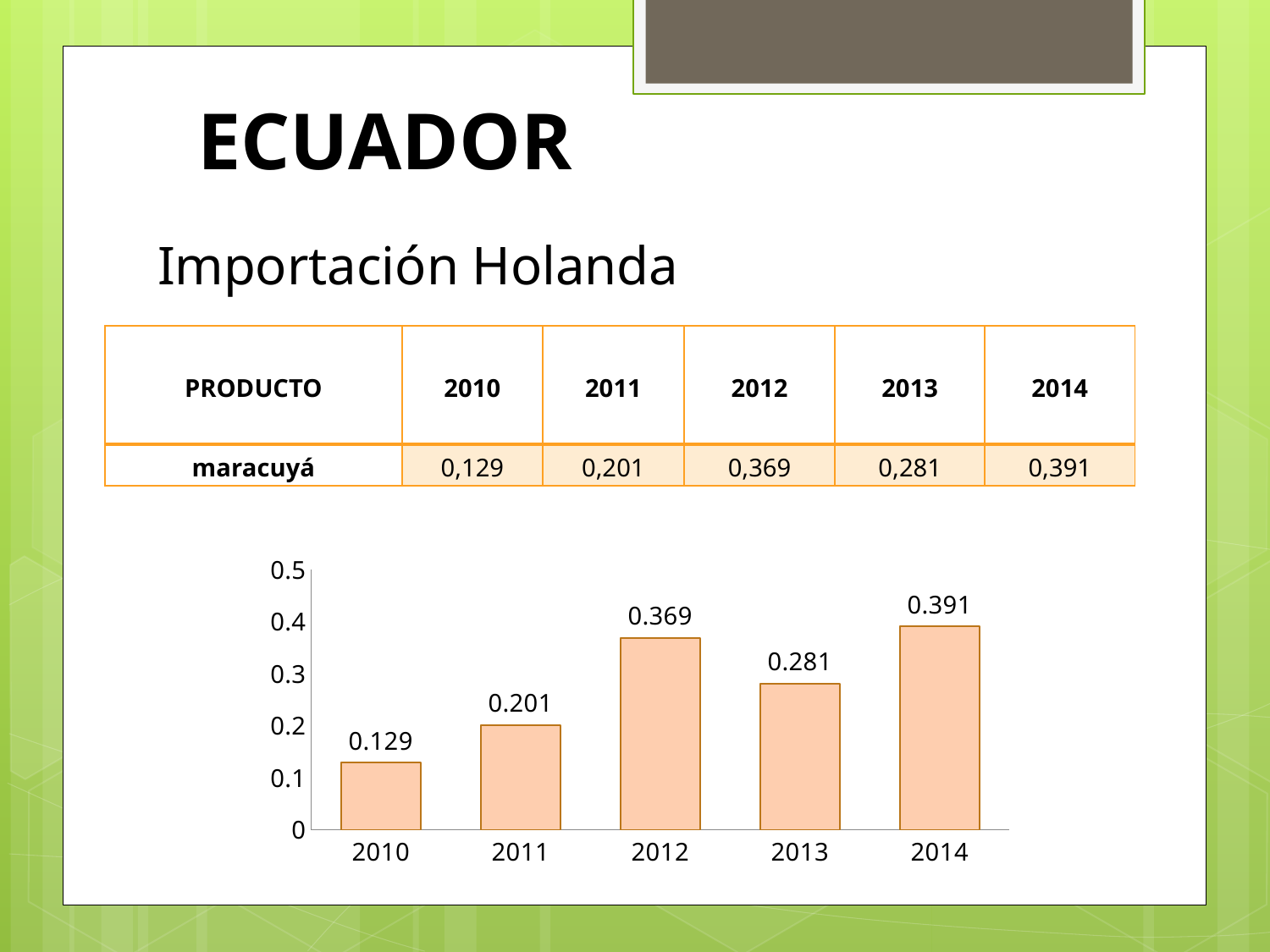
Which is larger in the bar chart, the value for 2011 or the value for 2013? 2013 What is the difference between the values for 2012 and 2013 in the bar chart? 0.088 Which year has the lowest value in the bar chart? 2010 What kind of chart is shown on the slide? bar chart What is the difference between the values for 2014 and 2010 in the bar chart? 0.262 Which year has the highest value in the bar chart? 2014 What is the value for 2012 in the bar chart? 0.369 Is the value for 2012 in the bar chart greater or less than 0.3? greater What is the value for 2010 in the bar chart? 0.129 Does the value rise or fall from 2012 to 2013 in the bar chart? fall What is the value for 2013 in the bar chart? 0.281 How many years are shown on the x axis of the bar chart? 5